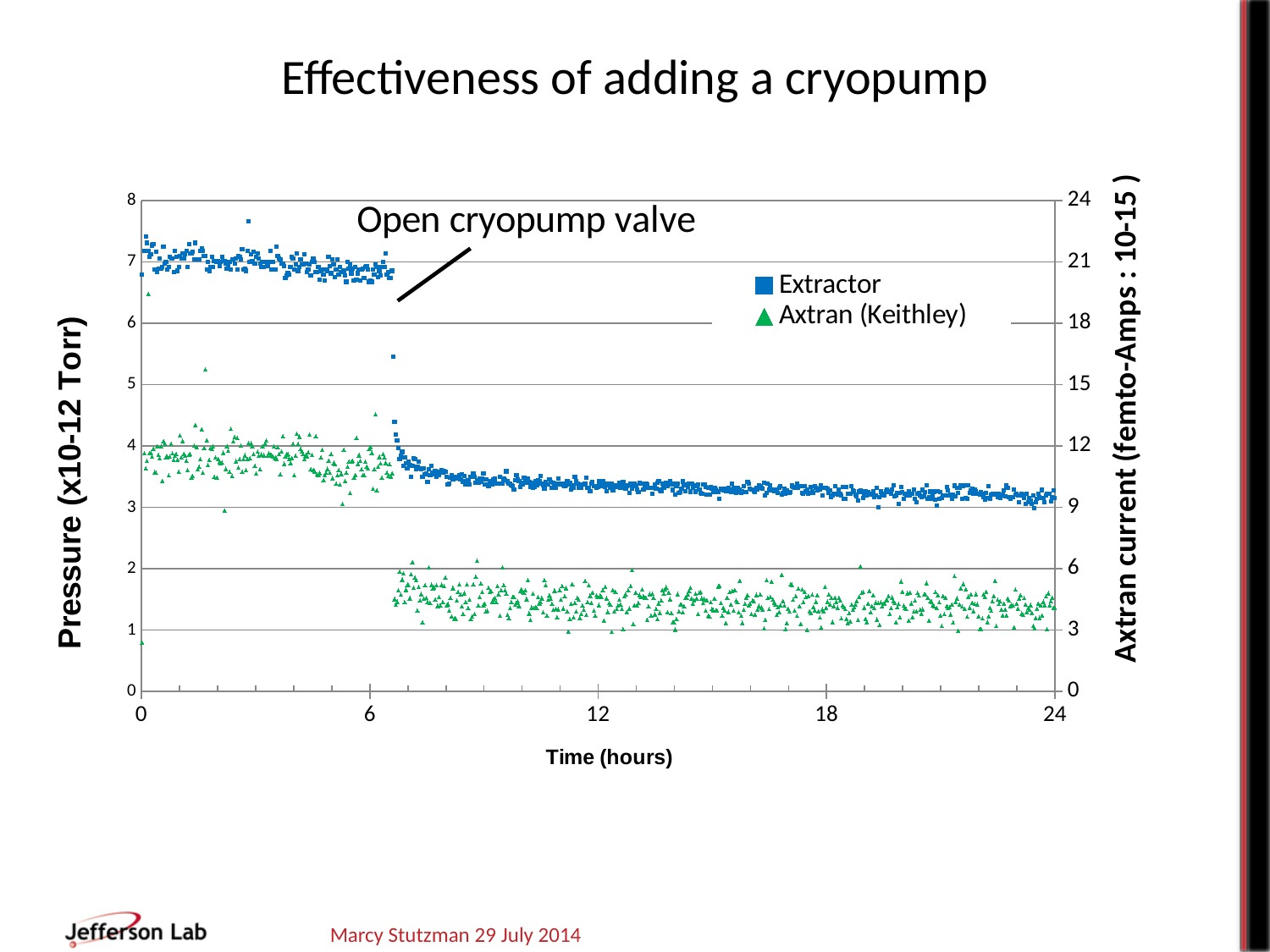
What is the title of the chart on the slide? Effectiveness of adding a cryopump Does the Axtran (Keithley) current rise or fall over the 24 hours shown? fall Is the Extractor pressure at 12 hours greater or less than 3 on the left axis? greater Which series has the higher value on the left axis at 12 hours, Extractor or Axtran (Keithley)? Extractor How many series does the chart legend list? 2 What kind of chart is shown on the slide? scatter chart Is the Axtran (Keithley) current at 18 hours greater or less than 6 on the right axis? less Is the Extractor pressure at 18 hours greater or less than 4 on the left axis? less Does the Extractor pressure rise or fall over the 24 hours shown? fall What is the label of the x axis? Time (hours)